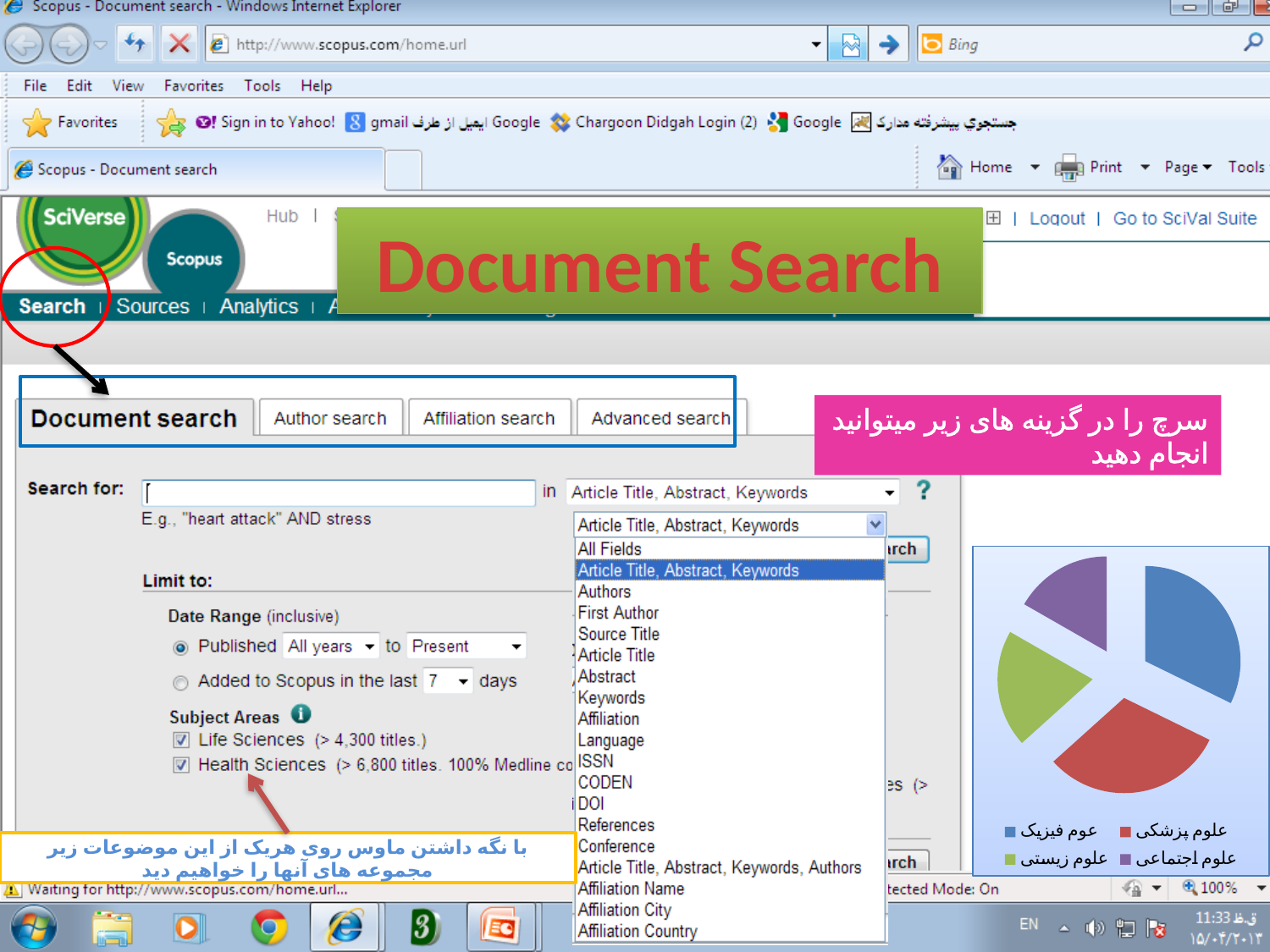
How many entries does the legend of the pie chart list? 4 What kind of chart is shown on the right side of the slide? pie chart In the pie chart, which category has the smallest slice? علوم اجتماعی In the pie chart, which slice is larger: علوم پزشکی or علوم اجتماعی? علوم پزشکی Which category does the green slice of the pie chart represent? علوم زیستی In the pie chart, which slice is larger: علوم زیستی or علوم اجتماعی? علوم زیستی What colour represents علوم پزشکی in the pie chart? red How many slices does the pie chart on the right side of the slide have? 4